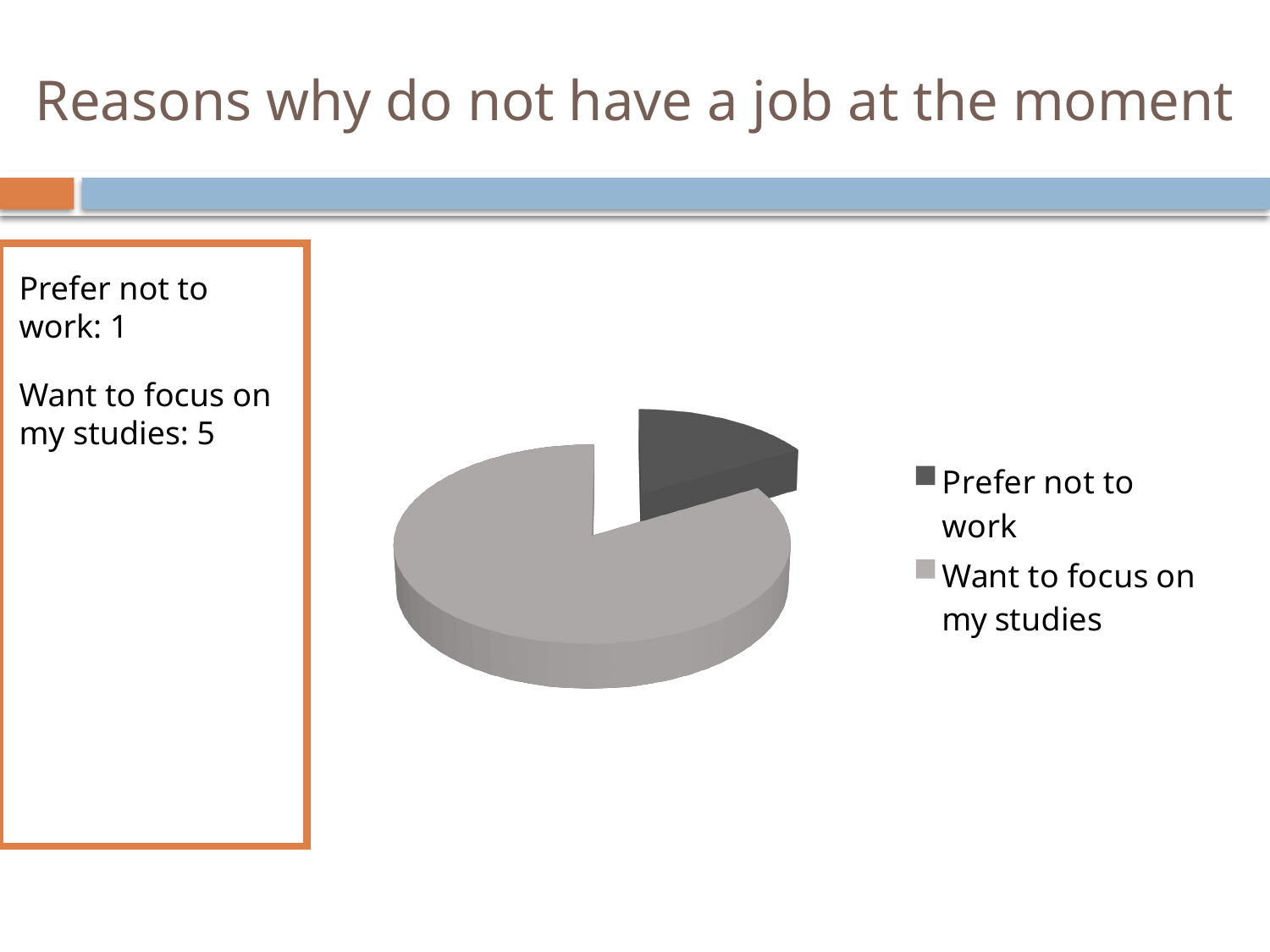
Which legend entry is shown in the darker grey colour? Prefer not to work What is the difference between the value for 'Want to focus on my studies' and the value for 'Prefer not to work'? 4 What is the title of the slide containing the pie chart? Reasons why do not have a job at the moment What is the value for 'Prefer not to work'? 1 Which category has the largest slice in the pie chart? Want to focus on my studies What is the value for 'Want to focus on my studies'? 5 What kind of chart is shown on the slide? Pie chart Which category has the smallest slice in the pie chart? Prefer not to work How many entries does the legend of the pie chart list? 2 How many slices does the pie chart have? 2 What is the total of the two values shown for the pie chart? 6 Which is larger: the slice for 'Prefer not to work' or the slice for 'Want to focus on my studies'? Want to focus on my studies